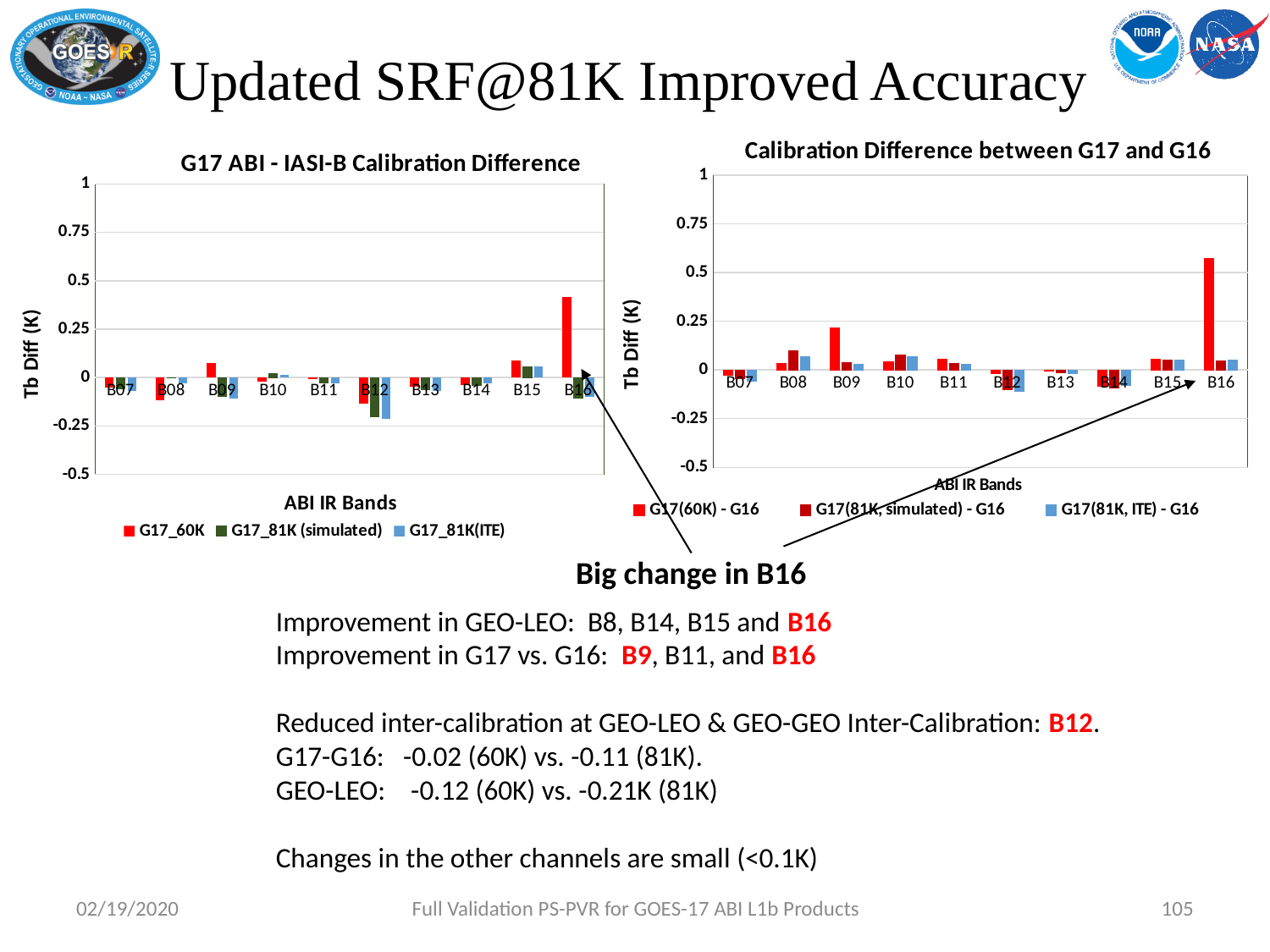
In the left chart (G17 ABI - IASI-B Calibration Difference), is the G17_81K(ITE) value for B12 greater or less than 0? less In the left chart (G17 ABI - IASI-B Calibration Difference), which band has the lowest G17_81K(ITE) bar? B12 How many series does the legend of the right chart (Calibration Difference between G17 and G16) list? 3 How many ABI IR bands are shown on the x axis of the left chart (G17 ABI - IASI-B Calibration Difference)? 10 What is the y-axis label of the right chart (Calibration Difference between G17 and G16)? Tb Diff (K) In the left chart (G17 ABI - IASI-B Calibration Difference), which is larger, the G17_60K value for B15 or for B16? B16 In the right chart (Calibration Difference between G17 and G16), is the G17(60K) - G16 value for B16 greater or less than 0.5? greater In the left chart (G17 ABI - IASI-B Calibration Difference), which band has the highest G17_60K bar? B16 In the left chart (G17 ABI - IASI-B Calibration Difference), is the G17_60K value for B16 greater or less than 0.25? greater What kind of chart is the left chart titled "G17 ABI - IASI-B Calibration Difference"? bar chart In the right chart (Calibration Difference between G17 and G16), which band has the highest G17(60K) - G16 bar? B16 What is the title of the left chart? G17 ABI - IASI-B Calibration Difference